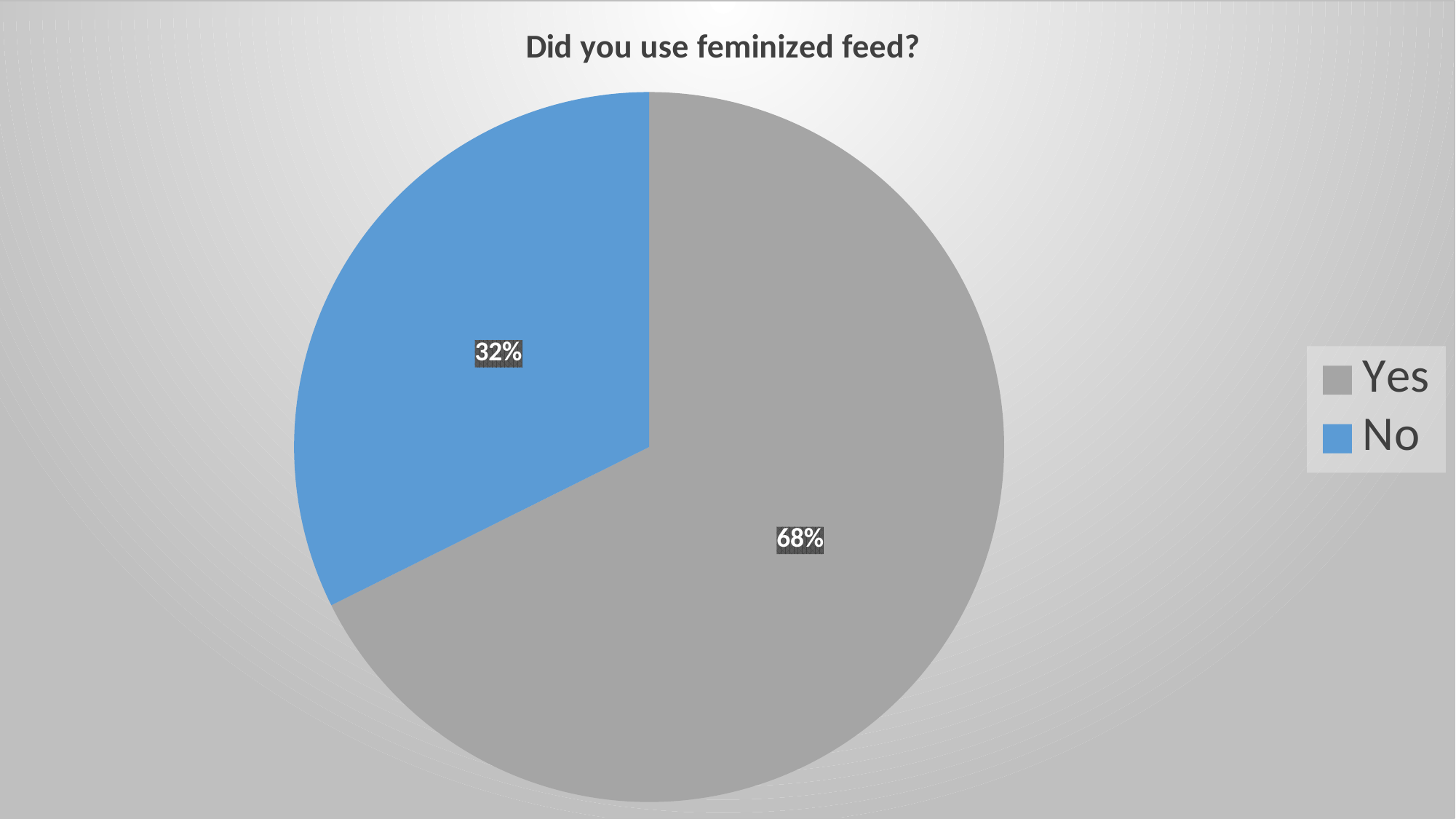
What colour is the "No" slice? Blue How many entries does the legend list? 2 What is the difference in percentage points between the "Yes" and "No" slices? 36 Which is larger, the "Yes" slice or the "No" slice? Yes What percentage of the pie is labelled "Yes"? 68% What is the title of the chart? Did you use feminized feed? How many slices does the pie chart have? 2 What percentage of the pie is labelled "No"? 32% What kind of chart is shown on the slide? Pie chart What share of the pie does the "No" slice represent? 32% Which slice of the pie is the largest? Yes Which slice of the pie is the smallest? No